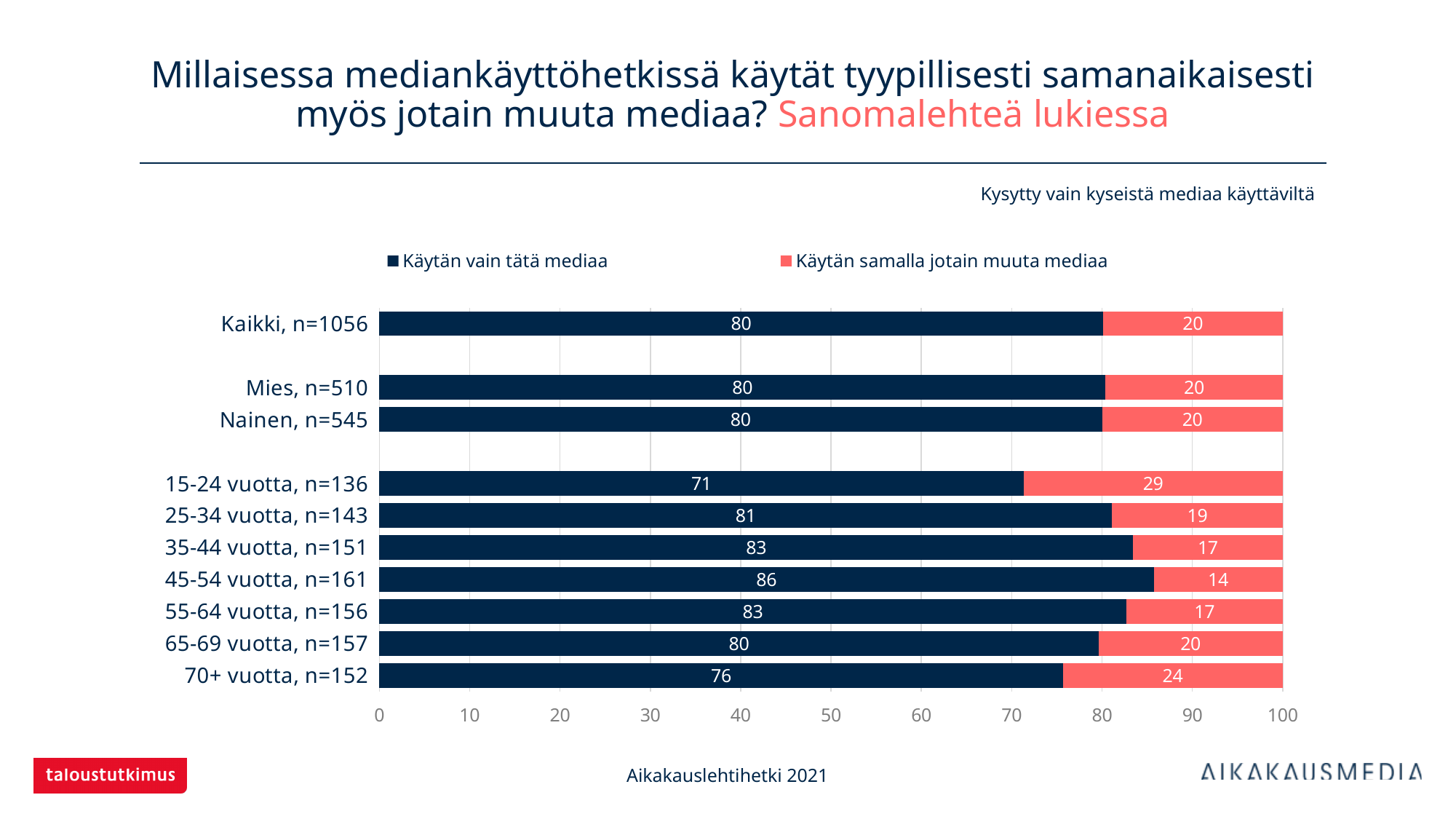
How many categories are shown on the chart? 10 What is the total of the stacked bar for "25-34 vuotta, n=143"? 100 What kind of chart is shown on the slide? Stacked bar chart Which category has the lowest value for "Käytän vain tätä mediaa"? 15-24 vuotta, n=136 What is the value of "Käytän vain tätä mediaa" for "45-54 vuotta, n=161"? 86 Which category has the highest value for "Käytän vain tätä mediaa"? 45-54 vuotta, n=161 Which is larger: the "Käytän vain tätä mediaa" value for "35-44 vuotta, n=151" or for "70+ vuotta, n=152"? 35-44 vuotta, n=151 What is the value of "Käytän samalla jotain muuta mediaa" for "15-24 vuotta, n=136"? 29 What is the difference between the "Käytän samalla jotain muuta mediaa" values for "15-24 vuotta, n=136" and "45-54 vuotta, n=161"? 15 How many series does the legend list? 2 What is the value of "Käytän samalla jotain muuta mediaa" for "70+ vuotta, n=152"? 24 What is the value of "Käytän vain tätä mediaa" for "Kaikki, n=1056"? 80